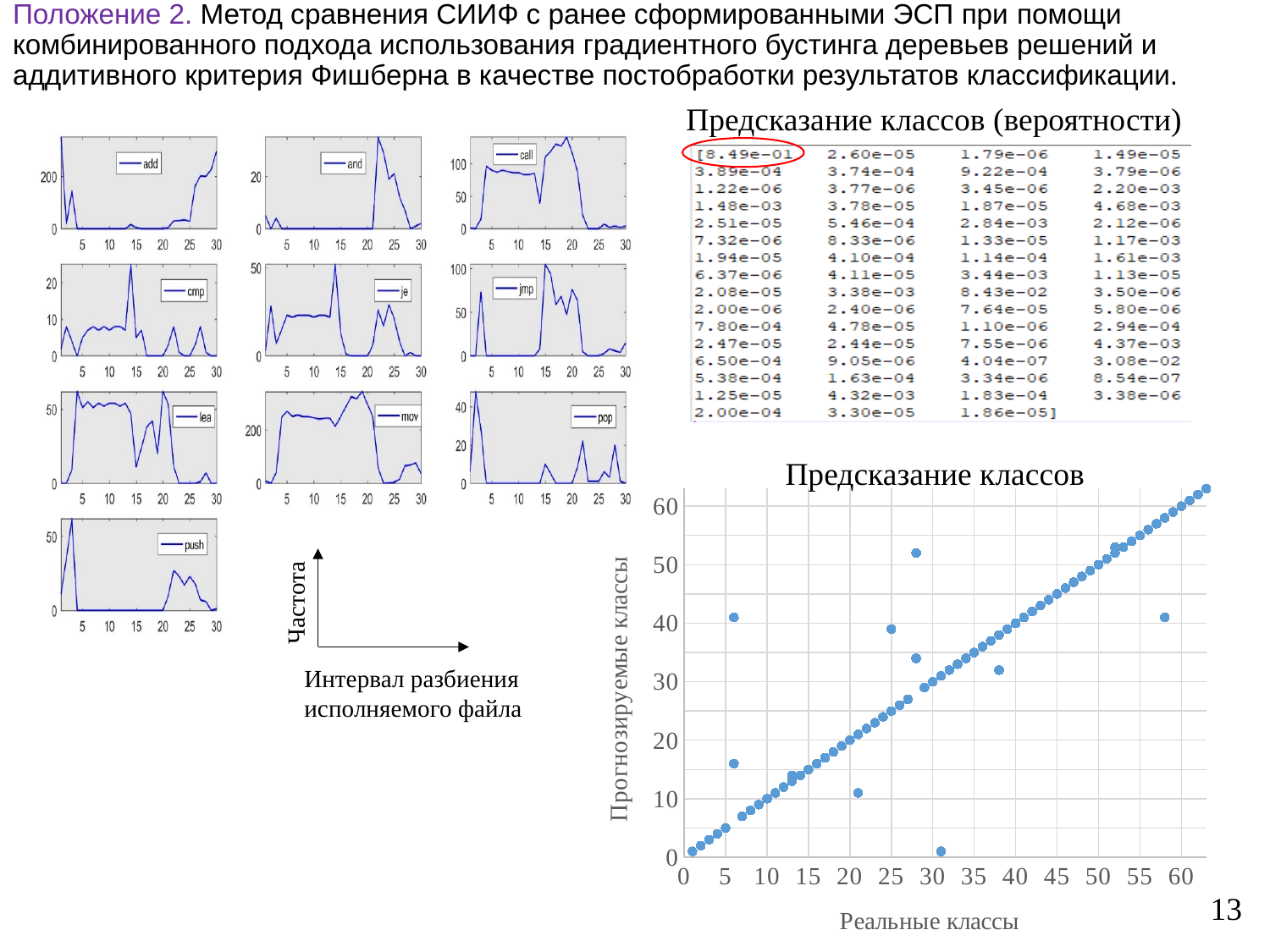
In the chart titled "Предсказание классов", is the predicted class value for the outlier point at real class 28 greater or less than 50? greater In the chart titled "Предсказание классов", do the predicted class values generally rise or fall as the real class values increase along the x axis? rise In the chart titled "Предсказание классов", what is the label of the x axis? Реальные классы In the chart titled "Предсказание классов", is the predicted class value for the outlier point near real class 31 greater or less than 10? less In the grid of small charts on the left, is the peak value in the "call" chart greater or less than 100? greater What kind of chart is the chart titled "Предсказание классов" in the lower right of the slide? scatter chart In the grid of small charts on the left, what is the legend entry of the chart in the top-left corner? add In the chart titled "Предсказание классов", what is the highest tick value shown on the y axis? 60 How many small line charts are shown in the grid on the left side of the slide? 10 What kind of chart is each of the small charts in the grid on the left side of the slide (add, and, call, etc.)? line chart In the grid of small charts on the left, what is the highest tick value shown on the x axis of the "push" chart? 30